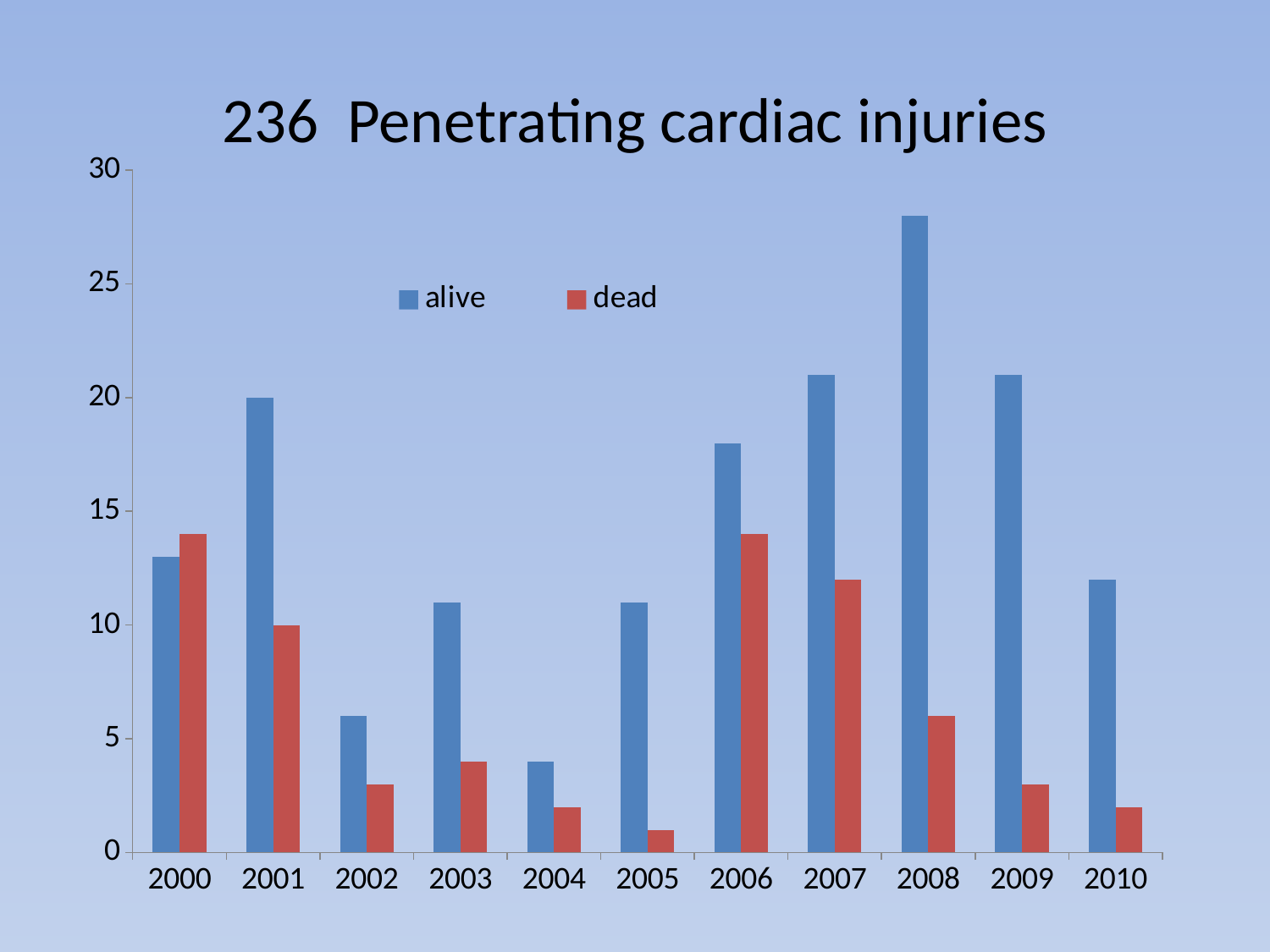
Is the value for dead in 2000 greater or less than 15? less Is the value for alive in 2008 greater or less than 25? greater How many years are shown on the x axis? 11 What is the value for alive in 2001? 20 What is the value for dead in 2001? 10 What is the title of the chart? 236 Penetrating cardiac injuries In which year is the dead value lowest? 2005 What type of chart is shown on the slide? bar chart In which year is the alive value highest? 2008 Which colour represents the dead series in the legend? red In 2007, which is larger, alive or dead? alive How many series does the legend list? 2